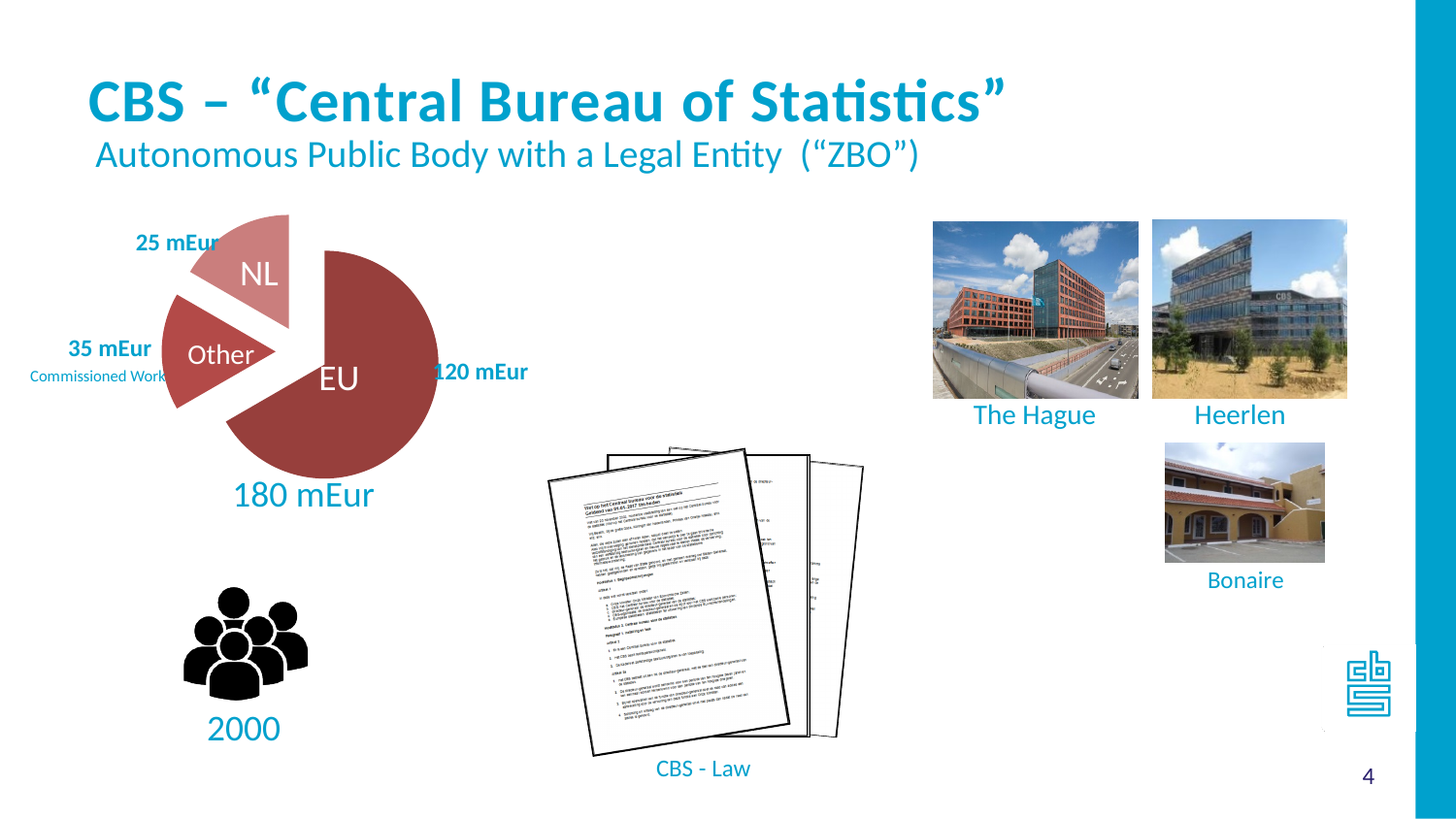
Which is larger in the pie chart, the Other slice or the NL slice? Other What is the difference between the EU slice and the Other slice in the pie chart? 85 mEur What is the difference between the Other slice and the NL slice in the pie chart? 10 mEur Which slice of the pie chart is the smallest? NL How many slices does the pie chart have? 3 What is the total value shown below the pie chart? 180 mEur What description is given under the 35 mEur label for the Other slice? Commissioned Work What is the value of the NL slice in the pie chart? 25 mEur What is the value of the EU slice in the pie chart? 120 mEur What kind of chart is shown on the slide? pie chart Which slice of the pie chart is the largest? EU What is the value of the Other slice in the pie chart? 35 mEur